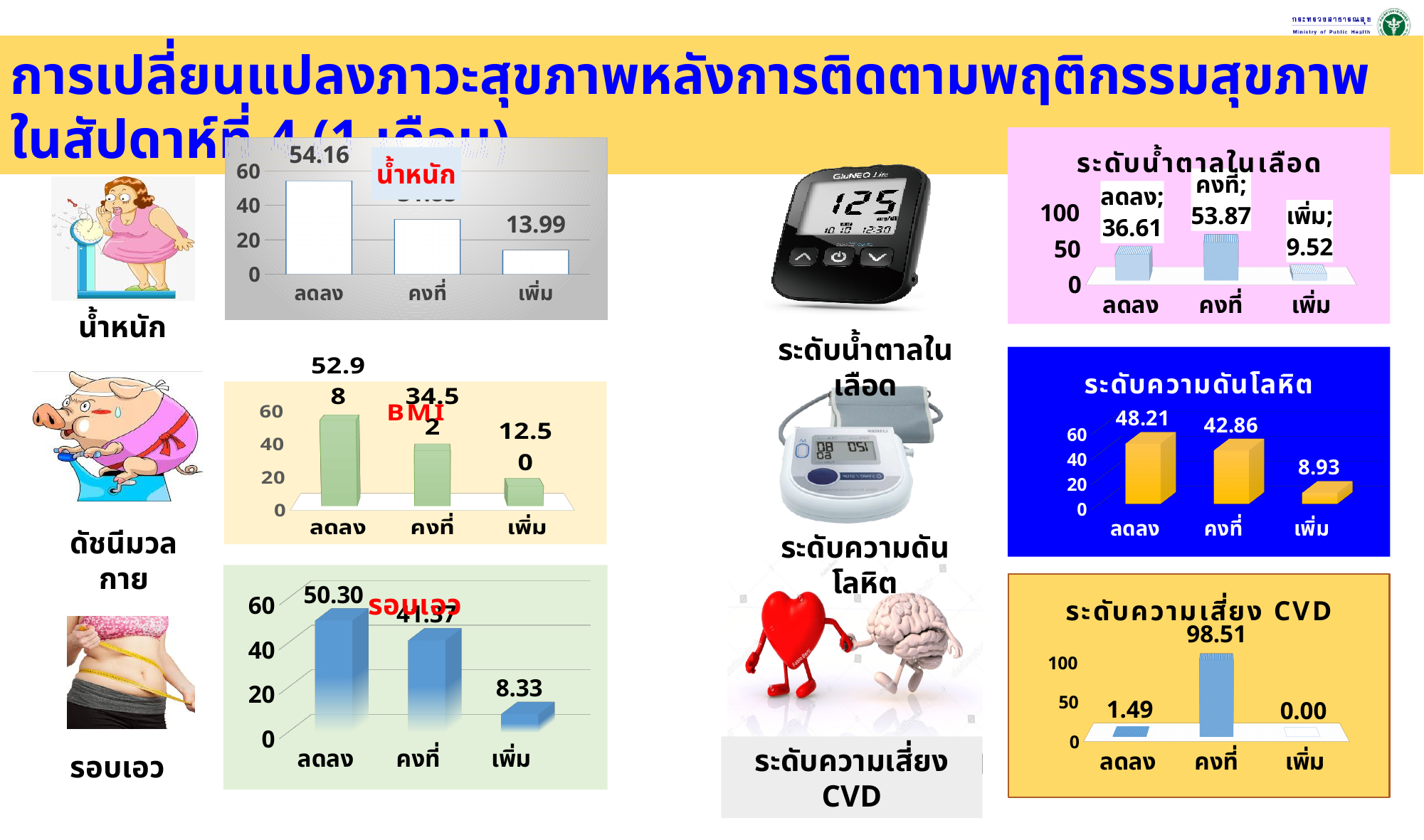
In the น้ำหนัก chart, what is the value for เพิ่ม? 13.99 In the รอบเอว chart, what is the value for เพิ่ม? 8.33 In the ระดับน้ำตาลในเลือด chart, what is the value for ลดลง? 36.61 In the ระดับความดันโลหิต chart, what is the difference between the values for ลดลง and คงที่? 5.35 In the น้ำหนัก chart, what is the value for ลดลง? 54.16 In the ระดับความดันโลหิต chart, which category has the lowest value? เพิ่ม How many categories does the ระดับความเสี่ยง CVD chart show? 3 In the ระดับน้ำตาลในเลือด chart, which category has the highest value? คงที่ In the ระดับความเสี่ยง CVD chart, what is the value for เพิ่ม? 0.00 In the ระดับความเสี่ยง CVD chart, what is the value for คงที่? 98.51 In the BMI chart, which is larger, the value for ลดลง or the value for คงที่? ลดลง In the รอบเอว chart, is the value for ลดลง greater or less than 40? greater